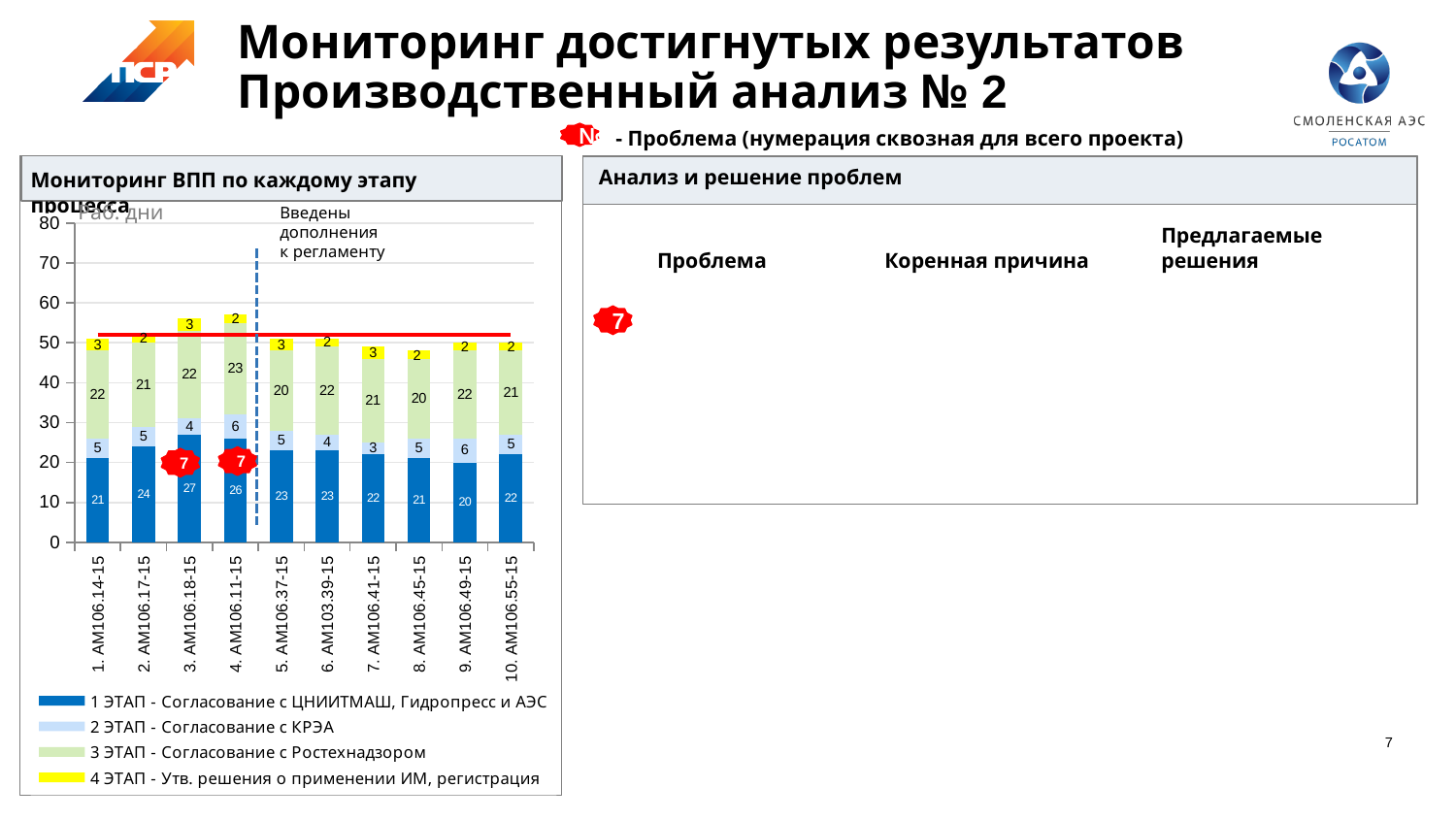
What is the value of "1 ЭТАП - Согласование с ЦНИИТМАШ, Гидропресс и АЭС" for "3. АМ106.18-15"? 27 Which is larger: the "3 ЭТАП - Согласование с Ростехнадзором" value for "4. АМ106.11-15" or for "5. АМ106.37-15"? 4. АМ106.11-15 What is the total of the stacked bar for "4. АМ106.11-15"? 57 Which category has the highest value for "1 ЭТАП - Согласование с ЦНИИТМАШ, Гидропресс и АЭС"? 3. АМ106.18-15 What kind of chart is shown under the heading "Мониторинг ВПП по каждому этапу процесса"? Stacked bar chart How many categories (bars) are plotted on the chart? 10 How many series does the chart legend list? 4 What is the value of "3 ЭТАП - Согласование с Ростехнадзором" for "4. АМ106.11-15"? 23 Which category has the lowest value for "1 ЭТАП - Согласование с ЦНИИТМАШ, Гидропресс и АЭС"? 9. АМ106.49-15 What unit label is shown at the top of the vertical axis of the chart? Раб. дни What is the value of "2 ЭТАП - Согласование с КРЭА" for "7. АМ106.41-15"? 3 What is the difference between the "1 ЭТАП" values for "3. АМ106.18-15" and "9. АМ106.49-15"? 7